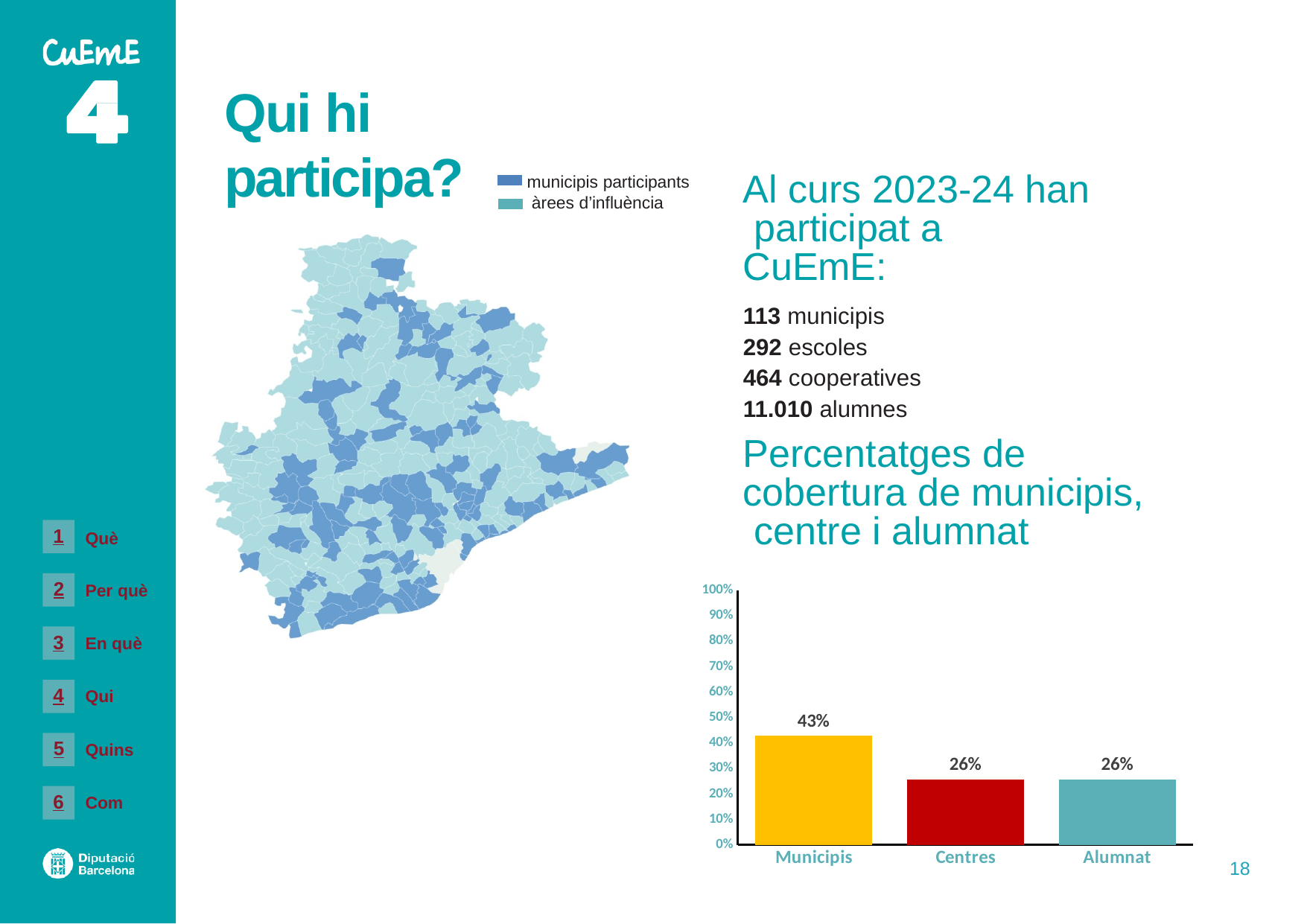
What is the highest value shown on the vertical axis of the bar chart? 100% What colour is the Municipis bar in the bar chart? yellow Is the value for Centres in the bar chart greater or less than 30%? less Which category has the highest value in the bar chart? Municipis How many categories are shown in the bar chart? 3 What is the value for Alumnat in the bar chart? 26% What is the difference between the values for Municipis and Centres in the bar chart? 17% What kind of chart is shown at the bottom right of the slide? bar chart What is the value for Municipis in the bar chart? 43% Is the value for Municipis in the bar chart greater or less than 40%? greater What is the value for Centres in the bar chart? 26% Which is larger in the bar chart, the value for Municipis or the value for Alumnat? Municipis